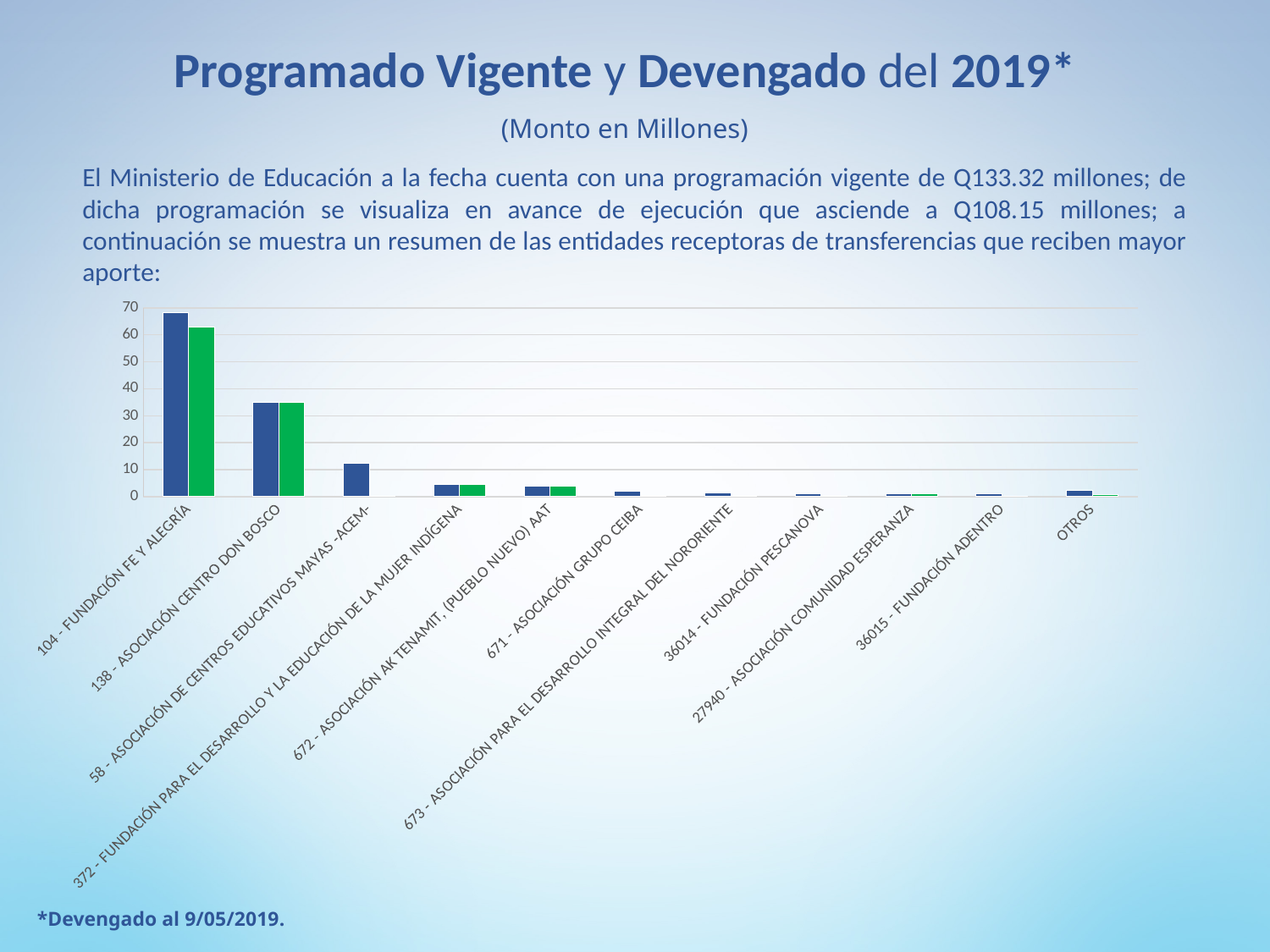
Is the blue bar for 104 - FUNDACIÓN FE Y ALEGRÍA greater or less than 60? greater Which category has the tallest bar in the chart? 104 - FUNDACIÓN FE Y ALEGRÍA Is the blue bar for 138 - ASOCIACIÓN CENTRO DON BOSCO greater or less than 30? greater Do the bar values generally rise or fall moving from left to right along the x axis? fall Is the blue bar for 372 - FUNDACIÓN PARA EL DESARROLLO Y LA EDUCACIÓN DE LA MUJER INDÍGENA greater or less than 10? less Which has a larger blue bar, 104 - FUNDACIÓN FE Y ALEGRÍA or 138 - ASOCIACIÓN CENTRO DON BOSCO? 104 - FUNDACIÓN FE Y ALEGRÍA What kind of chart is shown on the slide? bar chart How many categories are shown along the x axis of the chart? 11 What is the highest tick value shown on the vertical axis of the chart? 70